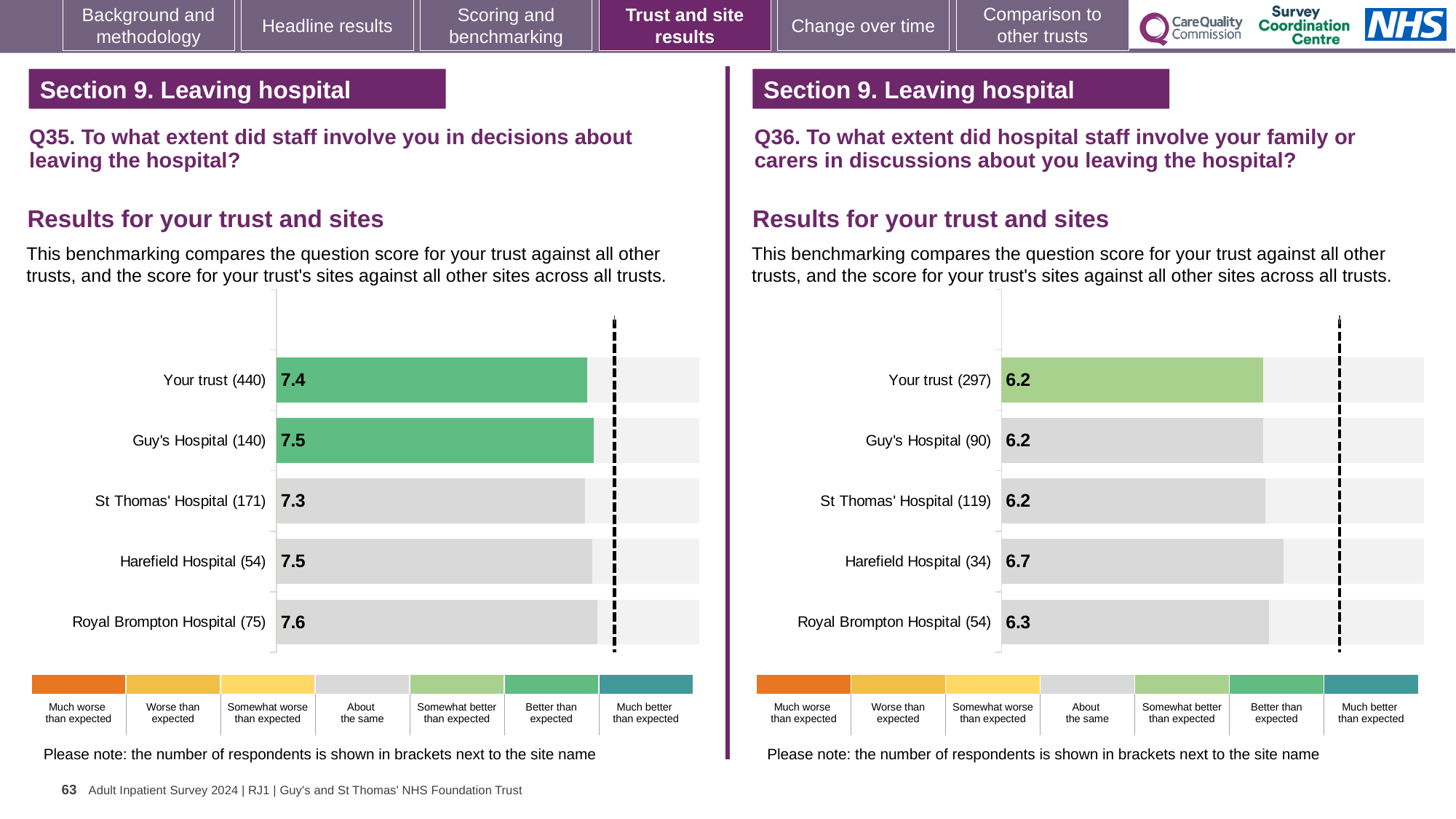
In the Q36 chart on the right, what is the score for Royal Brompton Hospital (54)? 6.3 How many bars are plotted in the Q35 chart on the left? 5 What kind of chart is used for the Q36 results on the right? bar chart In the Q36 chart on the right, what is the difference between the scores for Harefield Hospital and Your trust? 0.5 In the Q35 chart on the left, what is the difference between the scores for Royal Brompton Hospital and St Thomas' Hospital? 0.3 In the Q36 chart on the right, which site has the highest score? Harefield Hospital (34) In the Q36 chart on the right, is the score for Harefield Hospital larger or smaller than the score for Royal Brompton Hospital? larger In the Q35 chart on the left, which site has the lowest score? St Thomas' Hospital (171) In the Q35 chart on the left, what is the score for Your trust (440)? 7.4 In the Q35 chart on the left, what is the score for St Thomas' Hospital (171)? 7.3 In the Q36 chart on the right, what is the score for Harefield Hospital (34)? 6.7 In the Q35 chart on the left, which site has the highest score? Royal Brompton Hospital (75)